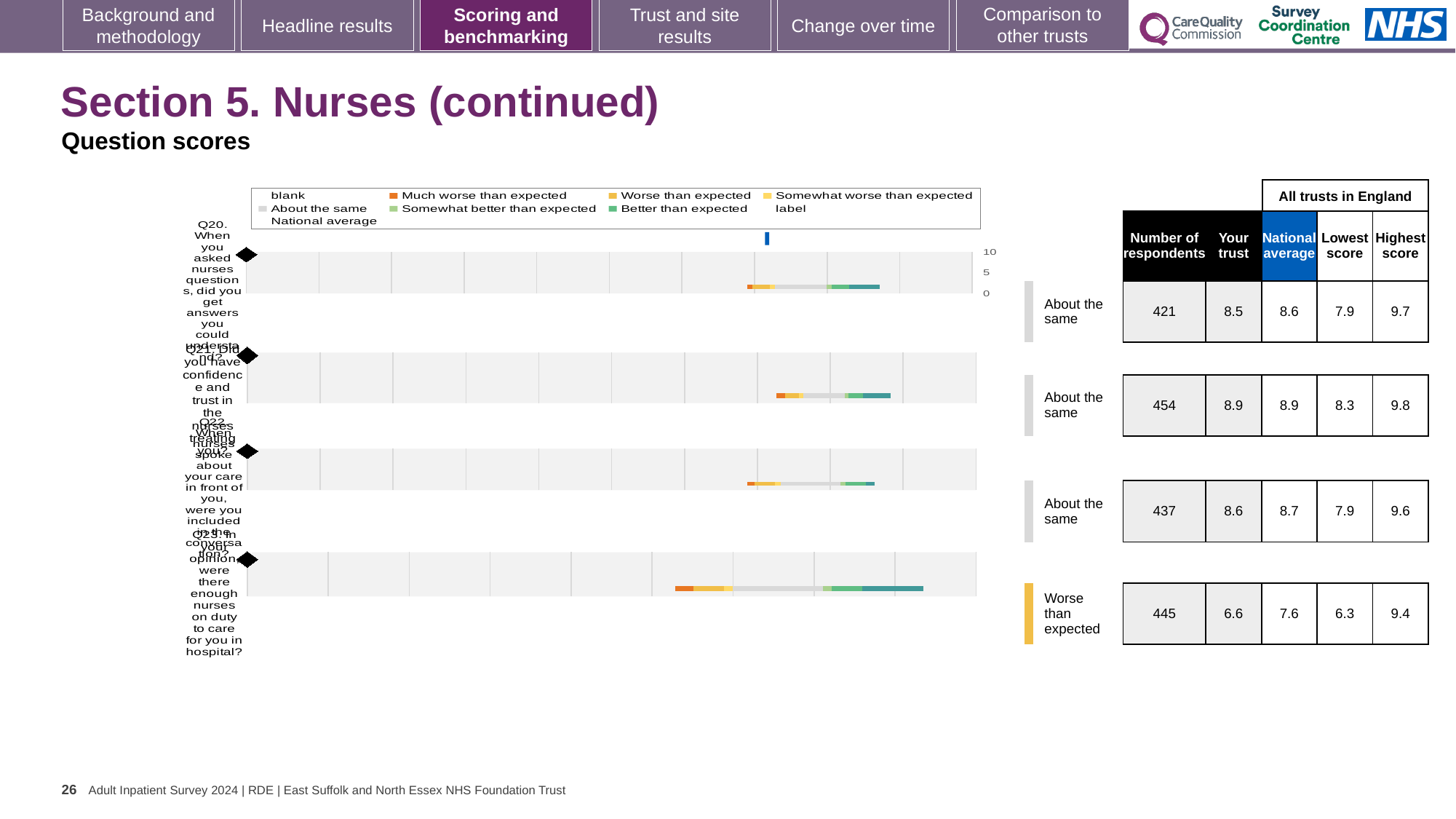
What is the 'Your trust' score for Q23 (were there enough nurses on duty)? 6.6 Which question has the lowest 'Your trust' score? Q23 Which benchmark category is shown for Q23? Worse than expected How many respondents answered Q20 (did you get answers you could understand)? 421 What is the highest score across all trusts in England for Q22? 9.6 How many questions (rows) are plotted in the chart? 4 What is the national average score for Q23 (were there enough nurses on duty)? 7.6 Which question has the highest 'Your trust' score? Q21 For Q20, which is larger: the 'Your trust' score or the national average? National average What is the 'Your trust' score for Q21 (confidence and trust in the nurses)? 8.9 What is the difference between the national average and the 'Your trust' score for Q23? 1.0 What kind of chart is used to show the question scores on this slide? bar chart